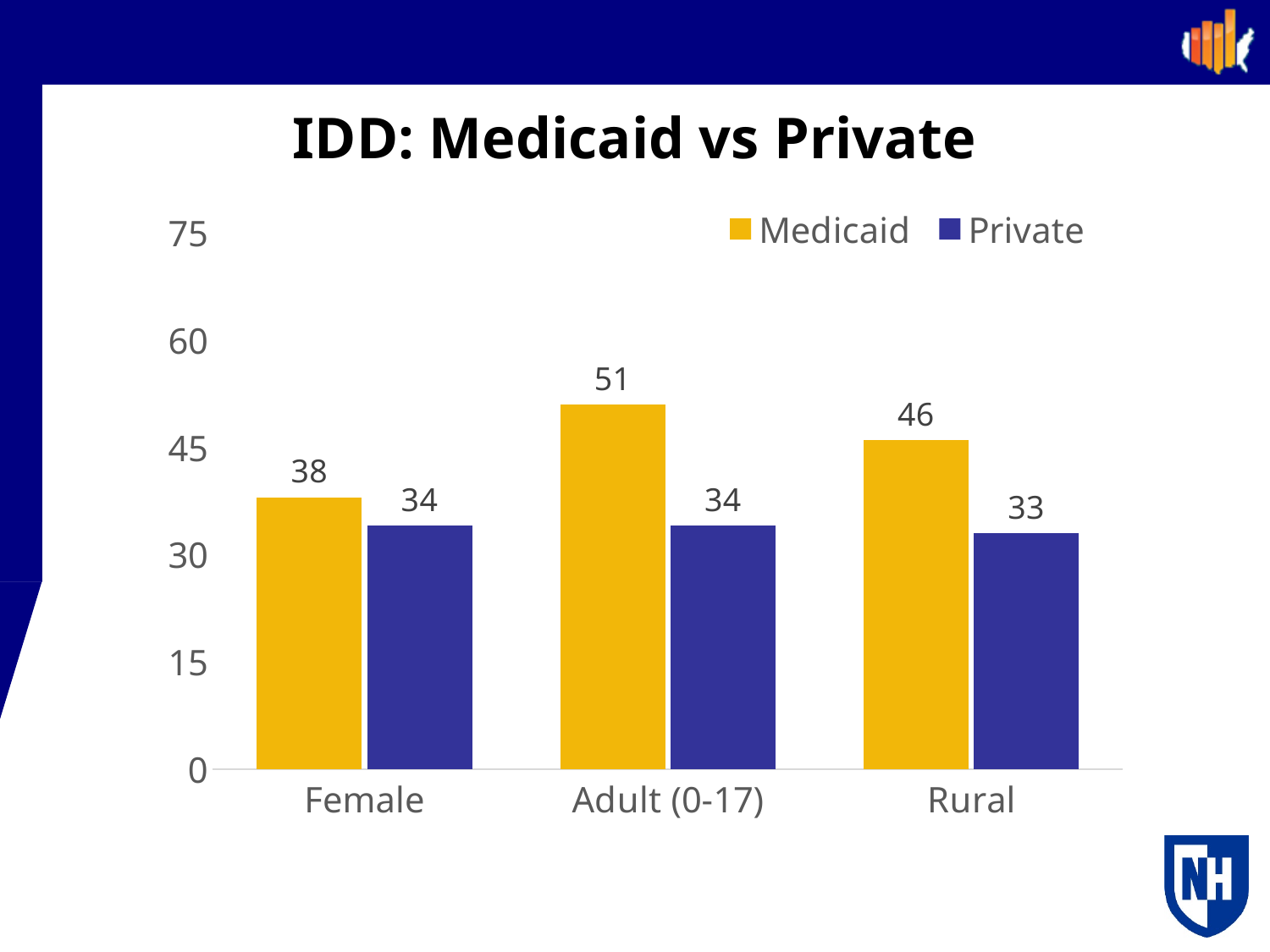
What type of chart is shown on the slide? Bar chart Which category has the highest Medicaid value? Adult (0-17) Which category has the lowest Private value? Rural What is the Private value for Adult (0-17)? 34 Is the Medicaid value for Adult (0-17) greater or less than 45? greater What is the Medicaid value for Female? 38 How many series does the legend list? 2 Which is larger for Female, the Medicaid value or the Private value? Medicaid How many categories are shown on the x axis? 3 What is the Medicaid value for Rural? 46 What is the Private value for Rural? 33 What is the difference between the Medicaid and Private values for Adult (0-17)? 17